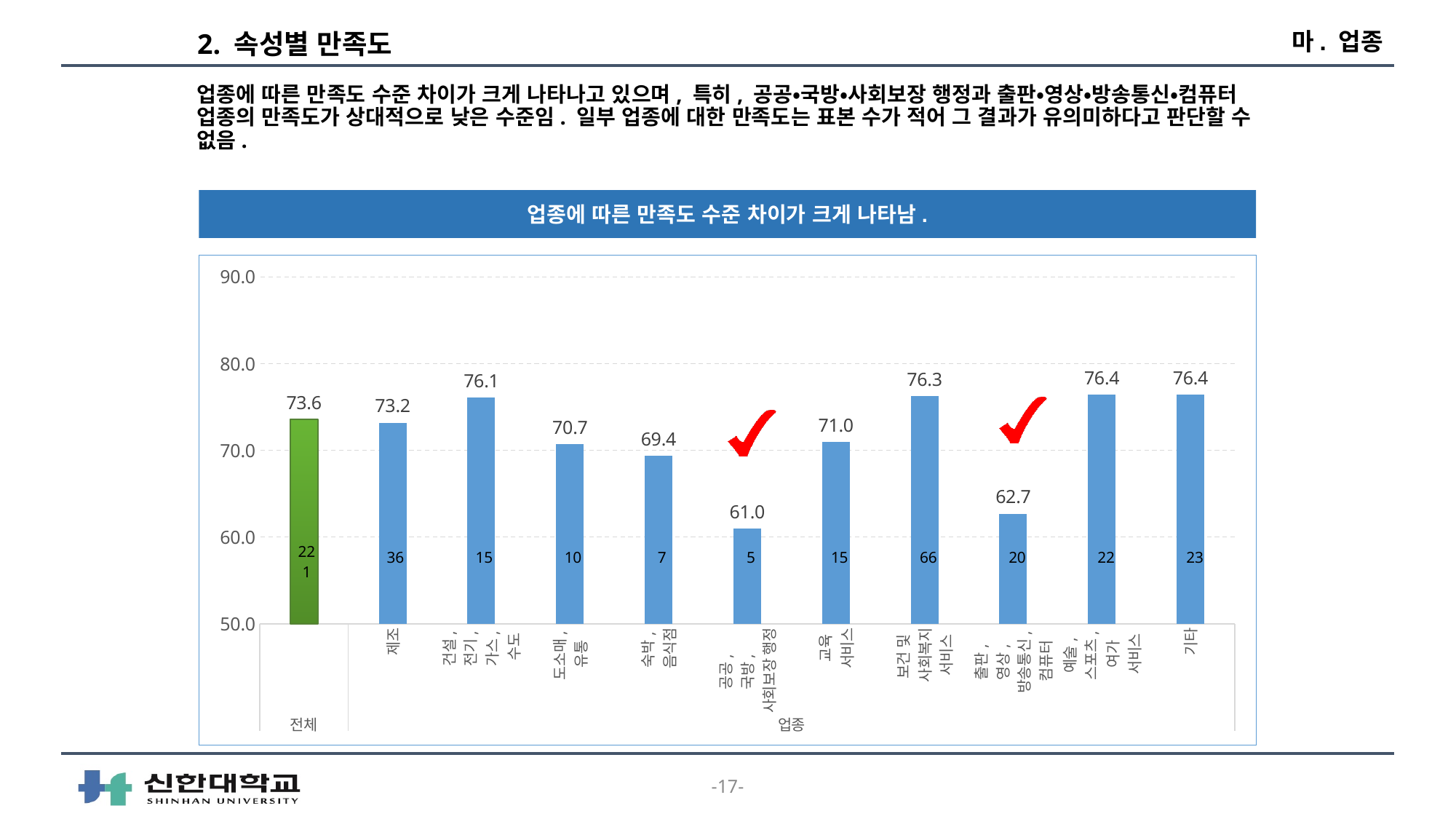
What is the satisfaction value for 제조? 73.2 What sample size number is printed inside the 보건 및 사회복지 서비스 bar? 66 What is the satisfaction value for 보건 및 사회복지 서비스? 76.3 What is the title shown in the blue banner above the chart? 업종에 따른 만족도 수준 차이가 크게 나타남. How many bars are plotted in the chart? 11 What is the satisfaction value for 공공, 국방, 사회보장 행정? 61.0 What type of chart is shown on the slide? bar chart What is the difference between the satisfaction values for 건설, 전기, 가스, 수도 and 도소매, 유통? 5.4 Which category has the lowest satisfaction value? 공공, 국방, 사회보장 행정 What is the satisfaction value for 출판, 영상, 방송통신, 컴퓨터? 62.7 Which has a higher satisfaction value, 교육 서비스 or 숙박, 음식점? 교육 서비스 What is the satisfaction value for 전체? 73.6